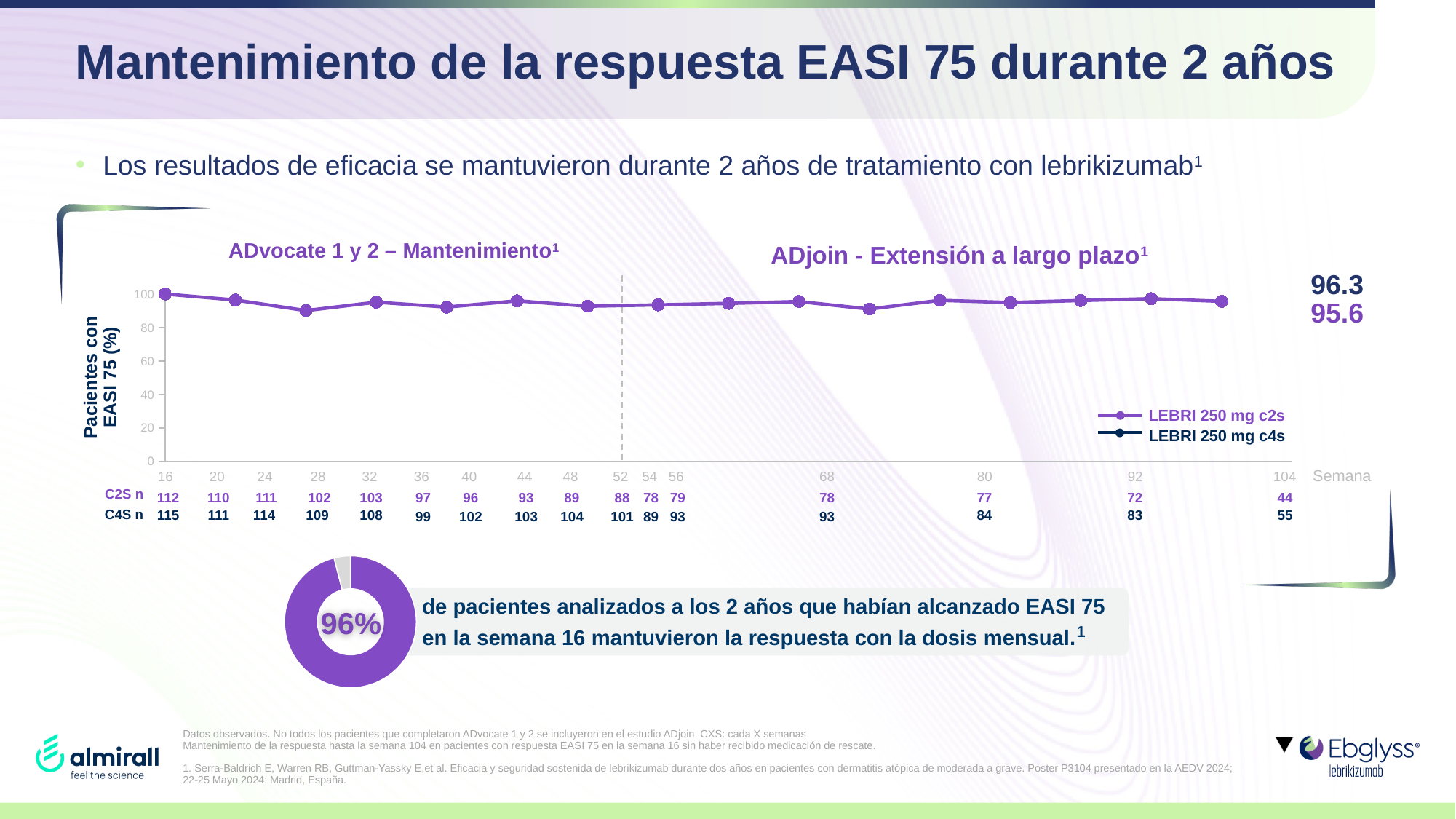
In the donut chart at the bottom of the slide, what share is shown for the highlighted slice? 96% Below the line chart, what is the C4S n value at week 104? 55 In the line chart, do the values rise, fall, or stay roughly flat from week 16 to week 104? roughly flat In the line chart, what are the two series named in the legend? LEBRI 250 mg c2s and LEBRI 250 mg c4s In the line chart, what two values are printed at the right end of the lines at week 104? 96.3 and 95.6 What kind of chart is the main chart showing patients with EASI 75 over weeks? line chart Below the line chart, what is the C2S n value at week 16? 112 In the line chart, is the value at week 68 greater or less than 80? greater In the line chart, what is the value plotted at week 16? 100 In the line chart, is the value at week 40 greater or less than 60? greater In the line chart, how many series does the legend list? 2 In the line chart, what is the label of the y axis? Pacientes con EASI 75 (%)